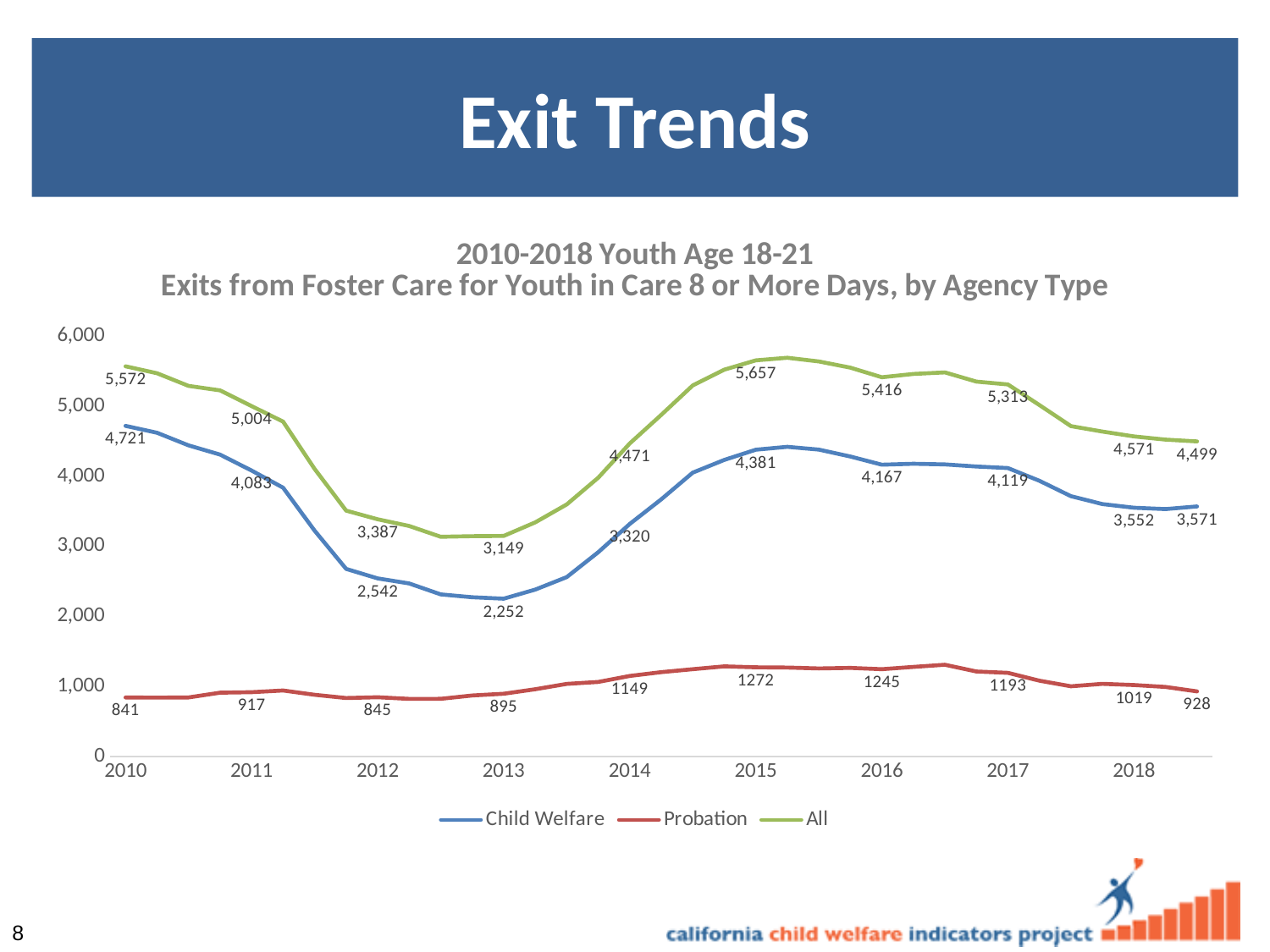
In which year is the Child Welfare series at its lowest? 2013 What is the All value for 2015? 5,657 Does the Child Welfare series rise or fall from 2010 to 2013? fall What kind of chart is shown on the slide? line chart What is the Child Welfare value for 2010? 4,721 Which is larger for Probation: the 2015 value or the 2016 value? 2015 Is the Child Welfare value for 2012 greater or less than 3,000? less How many series does the legend list? 3 What is the difference between the All value and the Child Welfare value in 2010? 851 What is the Probation value for 2013? 895 In which year is the All series at its highest? 2015 Which series is drawn in green? All